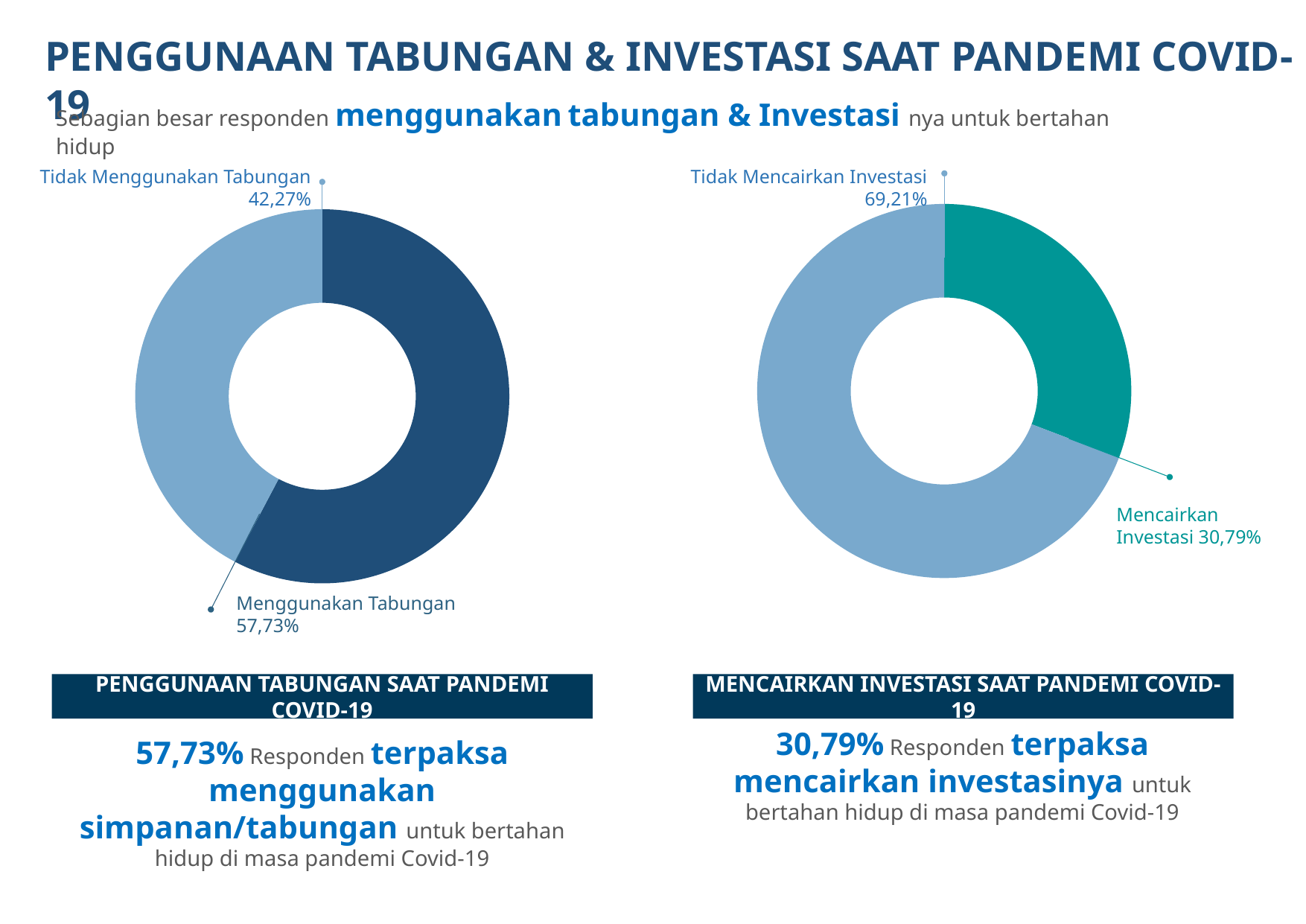
In the left chart (Penggunaan Tabungan), what percentage of respondents are labelled 'Tidak Menggunakan Tabungan'? 42,27% What type of chart is used on the left side of the slide? Pie chart (donut) In the right chart (Mencairkan Investasi), what percentage of respondents are labelled 'Mencairkan Investasi'? 30,79% Which is larger: the 'Menggunakan Tabungan' share in the left chart or the 'Mencairkan Investasi' share in the right chart? Menggunakan Tabungan How many categories does the right chart (Mencairkan Investasi) show? 2 In the right chart (Mencairkan Investasi), what is the difference in percentage points between 'Tidak Mencairkan Investasi' and 'Mencairkan Investasi'? 38,42 In the left chart (Penggunaan Tabungan), what percentage of respondents are labelled 'Menggunakan Tabungan'? 57,73% In the right chart (Mencairkan Investasi), which category has the smaller share? Mencairkan Investasi In the left chart (Penggunaan Tabungan), what is the difference in percentage points between 'Menggunakan Tabungan' and 'Tidak Menggunakan Tabungan'? 15,46 In the right chart (Mencairkan Investasi), what percentage of respondents are labelled 'Tidak Mencairkan Investasi'? 69,21% In the left chart (Penggunaan Tabungan), which category has the larger share? Menggunakan Tabungan In the right chart (Mencairkan Investasi), what colour is the 'Mencairkan Investasi' slice? Teal (green)